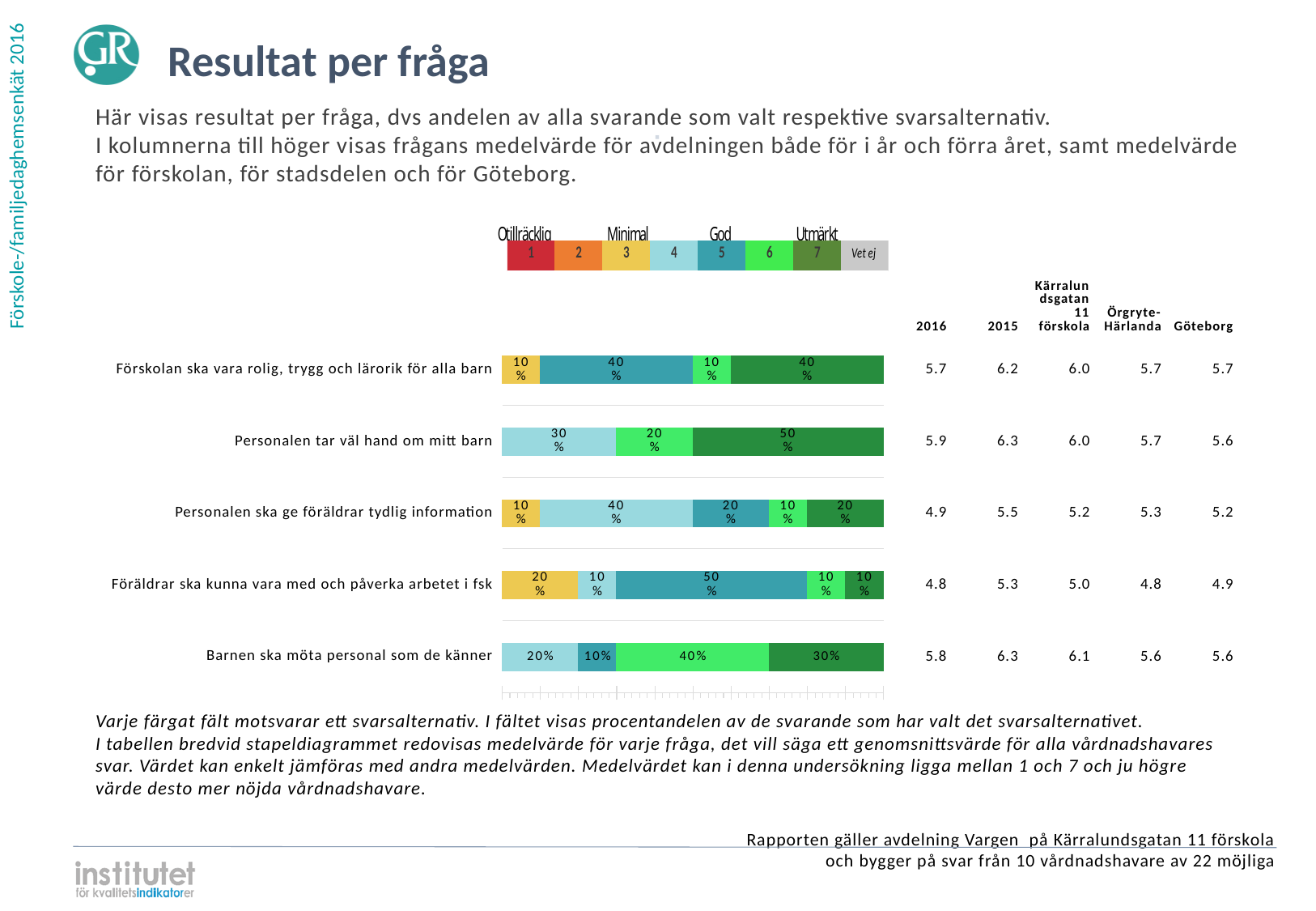
What percentage of respondents chose option 7 (dark green) for 'Personalen tar väl hand om mitt barn'? 50% What is the total of the stacked bar for 'Personalen tar väl hand om mitt barn'? 100% What kind of chart is shown on the slide? Stacked bar chart Which is larger for 'Barnen ska möta personal som de känner': the share for option 4 (light blue) or the share for option 7 (dark green)? Option 7 (30%) How many questions (categories) are plotted in the bar chart? 5 What percentage of respondents chose option 3 (yellow) for 'Föräldrar ska kunna vara med och påverka arbetet i fsk'? 20% How many response options does the legend above the chart list? 8 What is the difference between the option 7 share and the option 6 share for 'Förskolan ska vara rolig, trygg och lärorik för alla barn'? 30% What is the 2016 mean value shown for 'Personalen ska ge föräldrar tydlig information'? 4.9 What percentage of respondents chose option 4 (light blue) for 'Personalen ska ge föräldrar tydlig information'? 40% What percentage of respondents chose option 6 (bright green) for 'Barnen ska möta personal som de känner'? 40% Which response option has the largest share for 'Föräldrar ska kunna vara med och påverka arbetet i fsk'? 5 (50%)